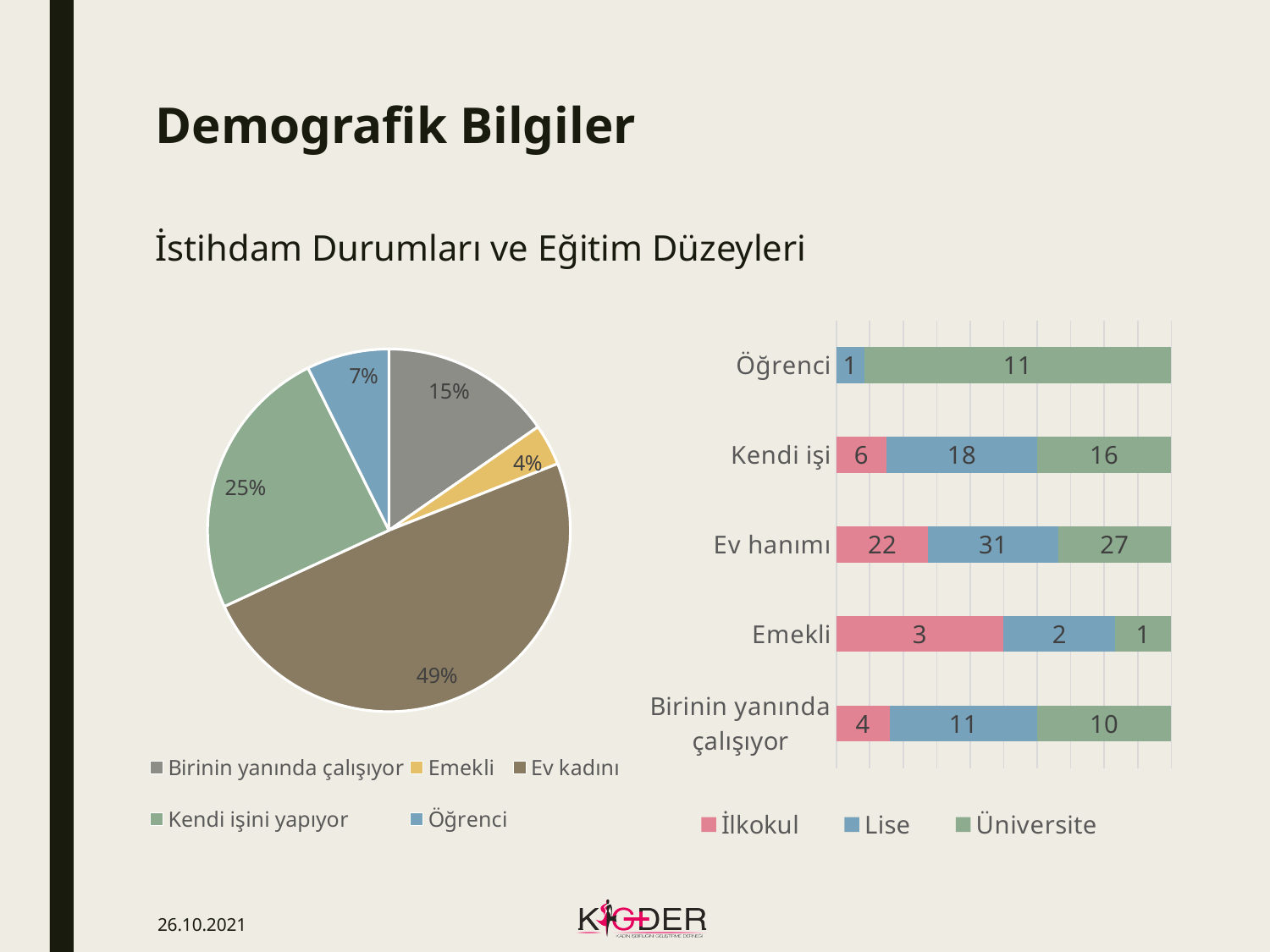
How many categories does the pie chart on the left have? 5 What kind of chart is the chart on the left? Pie chart In the bar chart on the right, what is the Üniversite value for Kendi işi? 16 In the bar chart on the right, what is the Lise value for Ev hanımı? 31 In the bar chart on the right, which has the larger Üniversite value, Ev hanımı or Birinin yanında çalışıyor? Ev hanımı In the bar chart on the right, what is the total of the Ev hanımı bar? 80 In the pie chart on the left, which category has the largest slice? Ev kadını How many series does the legend of the bar chart on the right list? 3 In the pie chart on the left, what percentage is shown for Kendi işini yapıyor? 25% In the pie chart on the left, which category has the smallest slice? Emekli In the bar chart on the right, what is the difference between the Lise and İlkokul values for Kendi işi? 12 In the pie chart on the left, what percentage is shown for Ev kadını? 49%